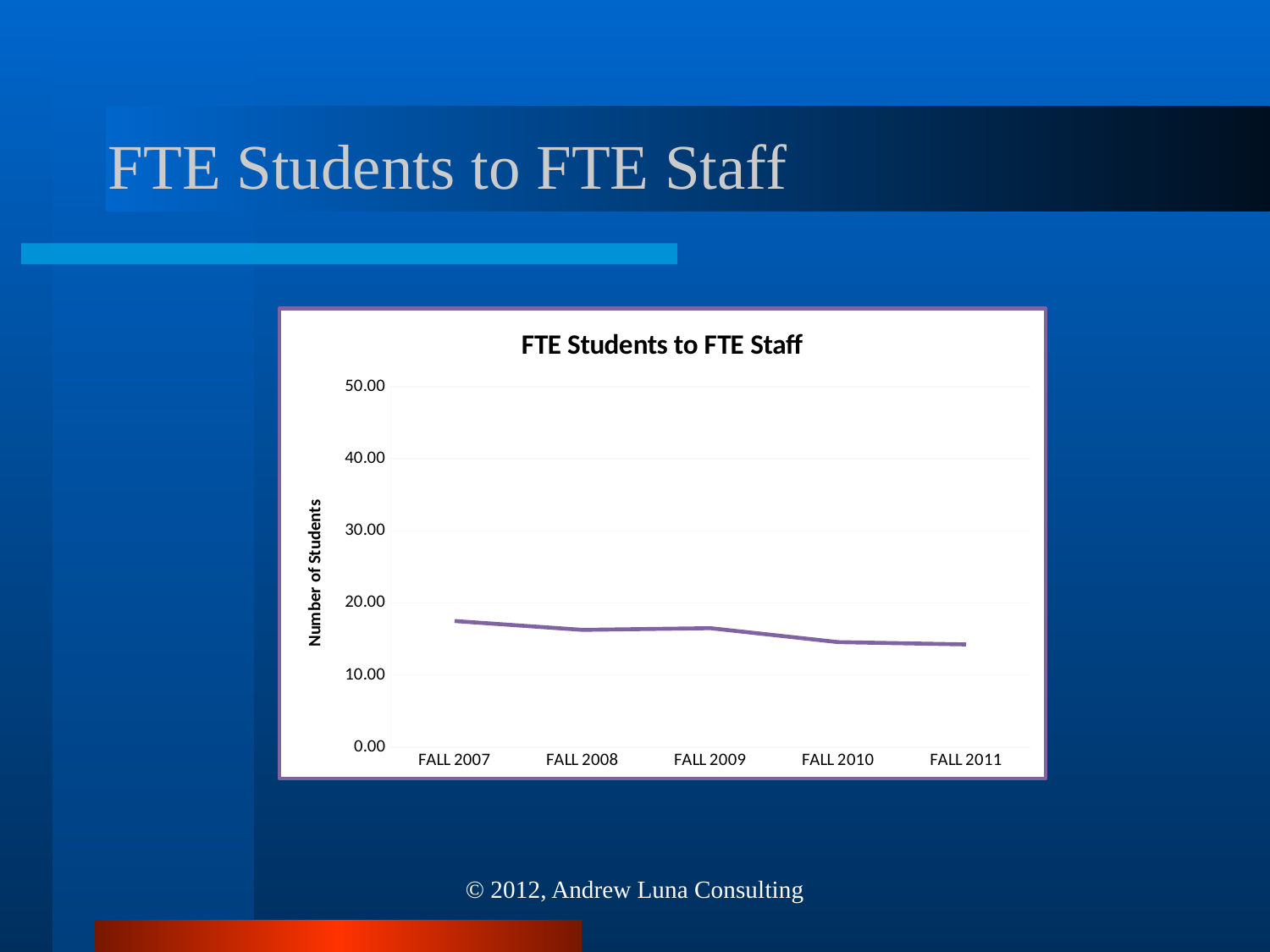
Which is larger, the value for FALL 2007 or the value for FALL 2011? FALL 2007 Which is larger, the value for FALL 2009 or the value for FALL 2010? FALL 2009 Do the values generally rise or fall from FALL 2007 to FALL 2011? fall What is the title of the chart? FTE Students to FTE Staff Which period has the highest value on the chart? FALL 2007 Is the value for FALL 2009 greater or less than 30.00? less Is the value for FALL 2011 greater or less than 10.00? greater How many data points are plotted on the line? 5 Is the value for FALL 2007 greater or less than 20.00? less What kind of chart is shown on the slide? line chart What is the label on the vertical axis of the chart? Number of Students What is the highest value shown on the vertical axis? 50.00